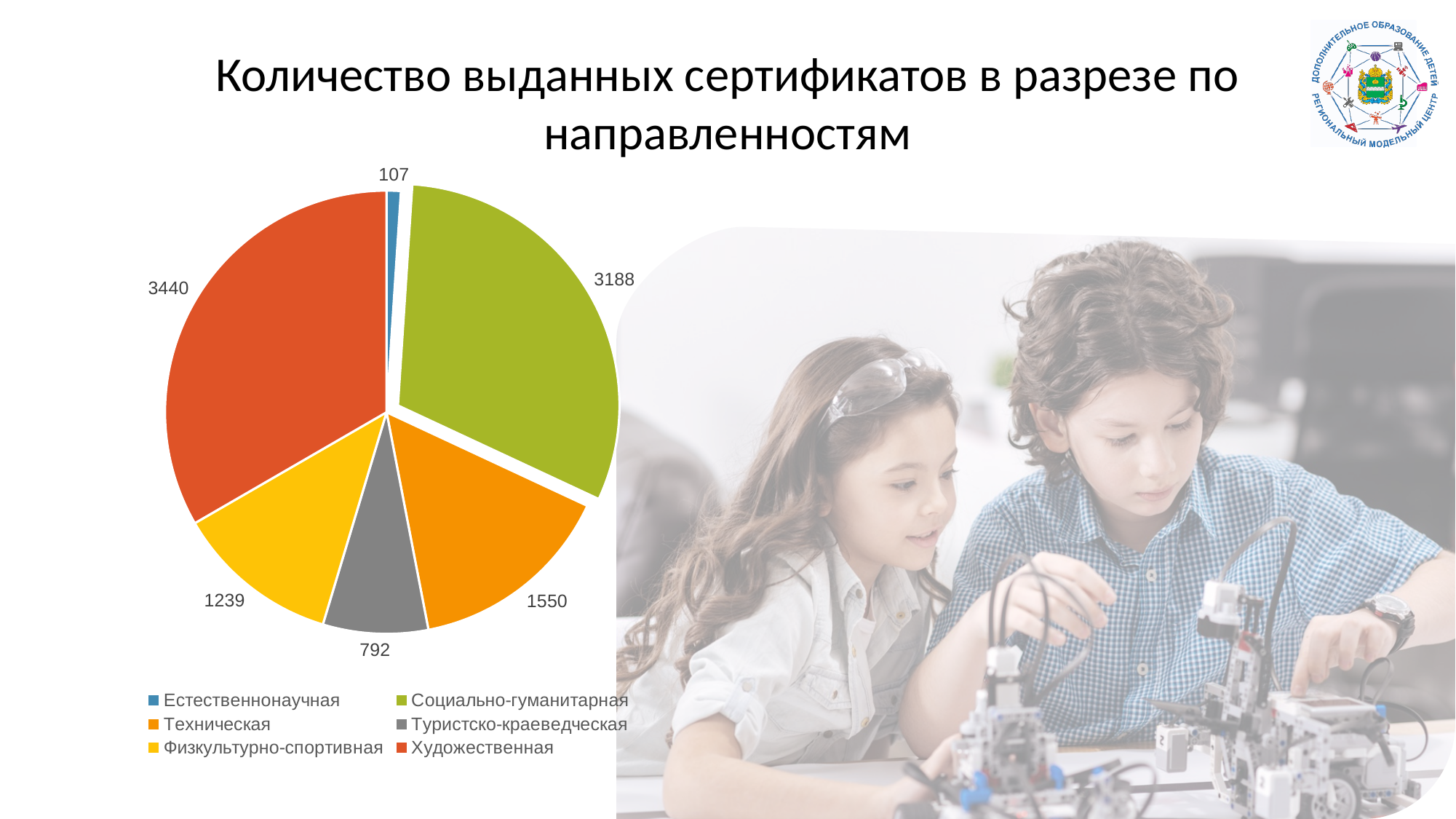
What share of the total does the Художественная slice represent? 33.3% What is the difference between the values for Техническая and Физкультурно-спортивная? 311 Which category has the largest value? Художественная What is the value for Социально-гуманитарная? 3188 Which is larger, the value for Техническая or the value for Туристско-краеведческая? Техническая What is the difference between the values for Художественная and Социально-гуманитарная? 252 Which category has the smallest value? Естественнонаучная What kind of chart is shown on the slide? pie chart How many categories does the pie chart have? 6 What colour is the Физкультурно-спортивная slice? yellow What is the value for Художественная? 3440 What is the value for Туристско-краеведческая? 792